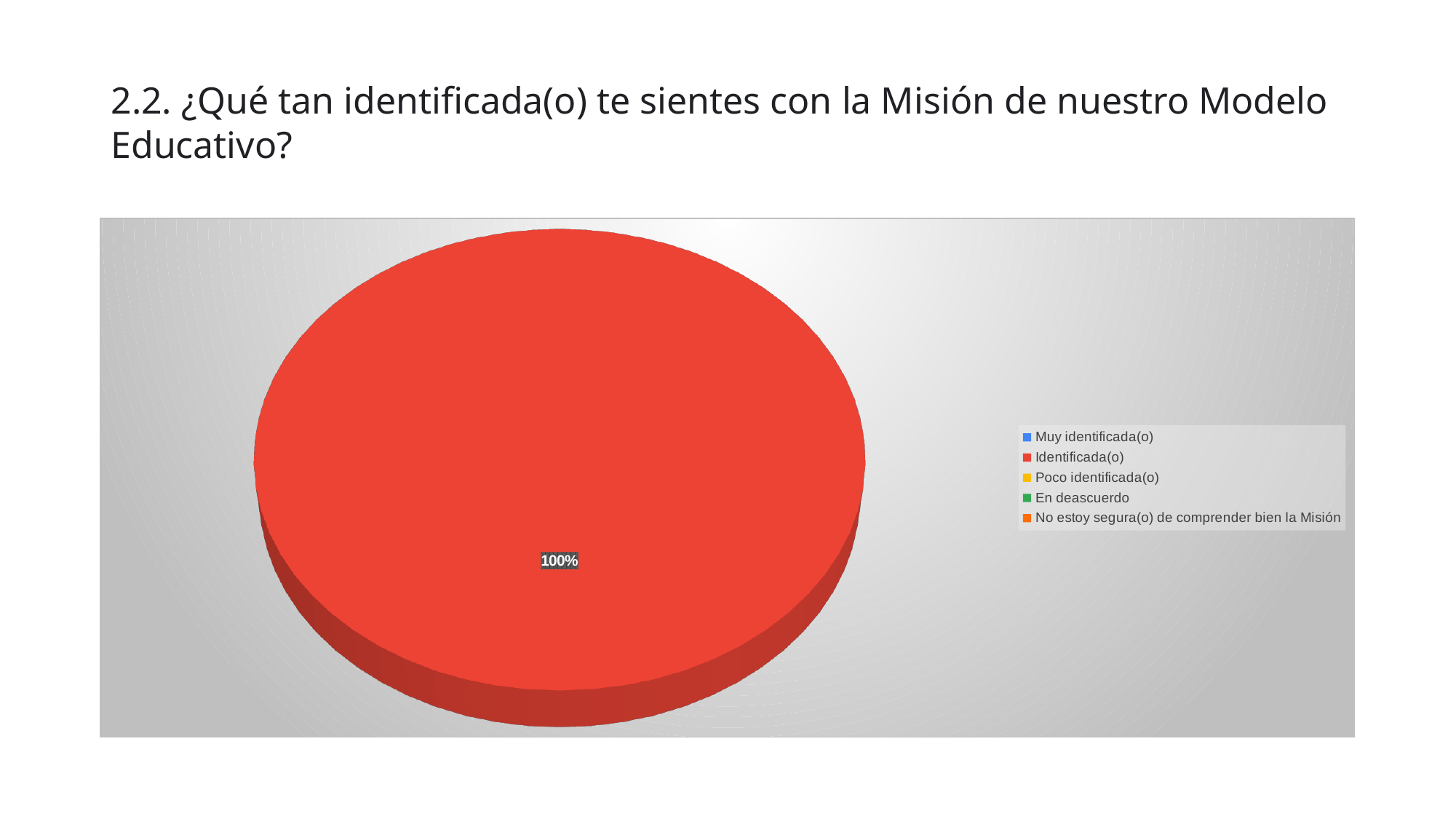
Which colour represents "Identificada(o)" in the legend? Red Which is larger, the share for "Identificada(o)" or the share for "Muy identificada(o)"? Identificada(o) What share of the pie does the "Identificada(o)" slice take? 100% What is the last entry listed in the legend? No estoy segura(o) de comprender bien la Misión How many categories does the legend list? 5 Is the share for "Identificada(o)" greater or less than 50%? greater Which category accounts for the entire pie? Identificada(o) What kind of chart is shown on the slide? Pie chart What is the data label printed on the pie slice? 100%